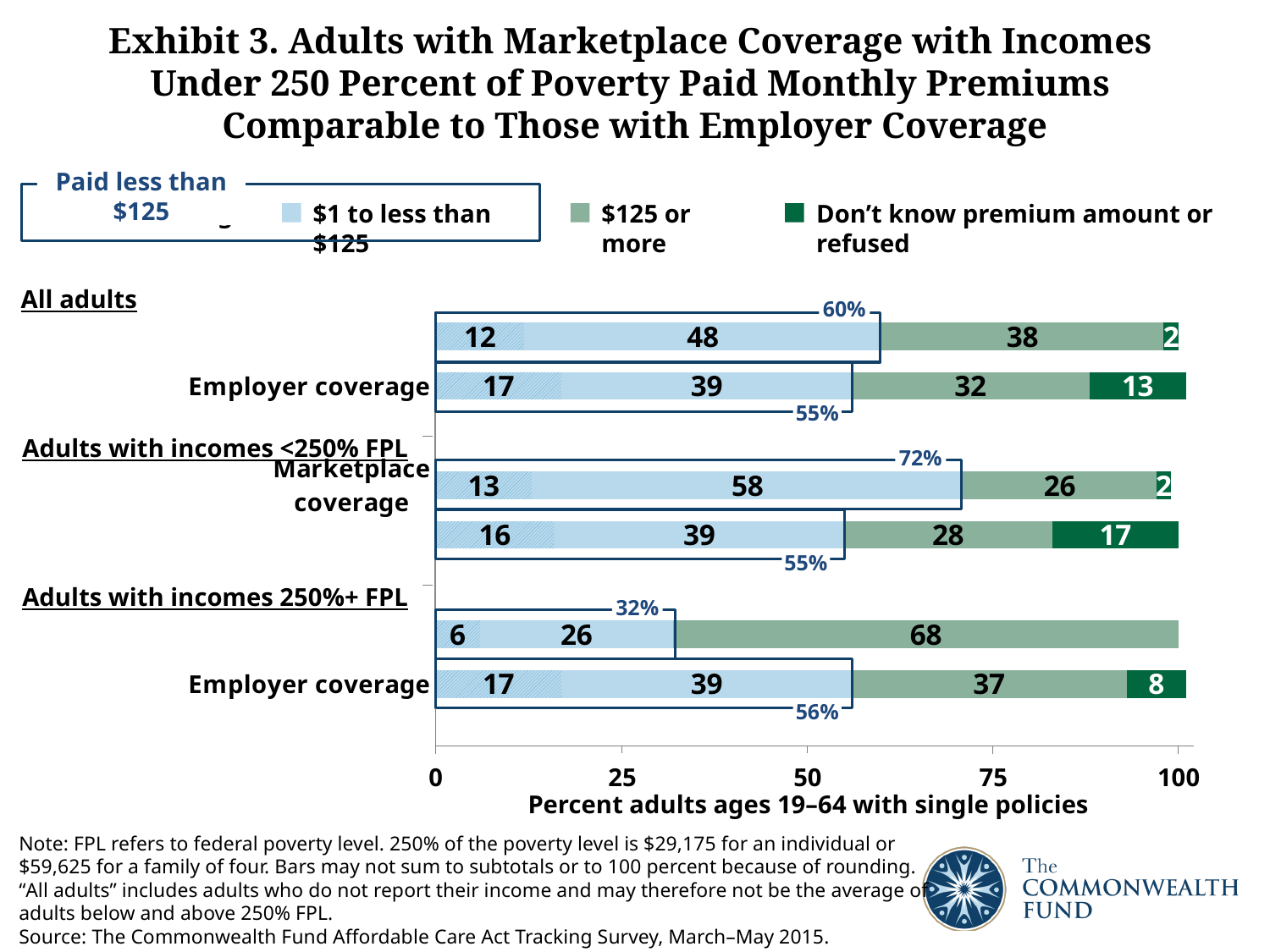
What is the "$1 to less than $125" value for Employer coverage among all adults? 39 What is the x-axis title of the chart? Percent adults ages 19–64 with single policies What is the value for "$125 or more" for Employer coverage among adults with incomes <250% FPL? 28 Is the "Paid less than $125" subtotal for Employer coverage among adults with incomes 250%+ FPL greater or less than 50? greater Among the three Employer coverage bars, which group has the lowest "Don't know premium amount or refused" value? Adults with incomes 250%+ FPL What share of adults with incomes <250% FPL with Marketplace coverage paid less than $125, according to the subtotal label? 72% What is the total of the Employer coverage bar for adults with incomes <250% FPL? 100 What is the difference between the "Don't know premium amount or refused" values for Employer coverage among adults with incomes <250% FPL and Employer coverage among all adults? 4 What is the value for "$1 to less than $125" for Marketplace coverage among adults with incomes <250% FPL? 58 What is the "Don't know premium amount or refused" value for Employer coverage among adults with incomes 250%+ FPL? 8 What kind of chart is shown on the slide? Stacked bar chart Which has a larger "$125 or more" value: Employer coverage among all adults or Employer coverage among adults with incomes 250%+ FPL? Employer coverage among adults with incomes 250%+ FPL